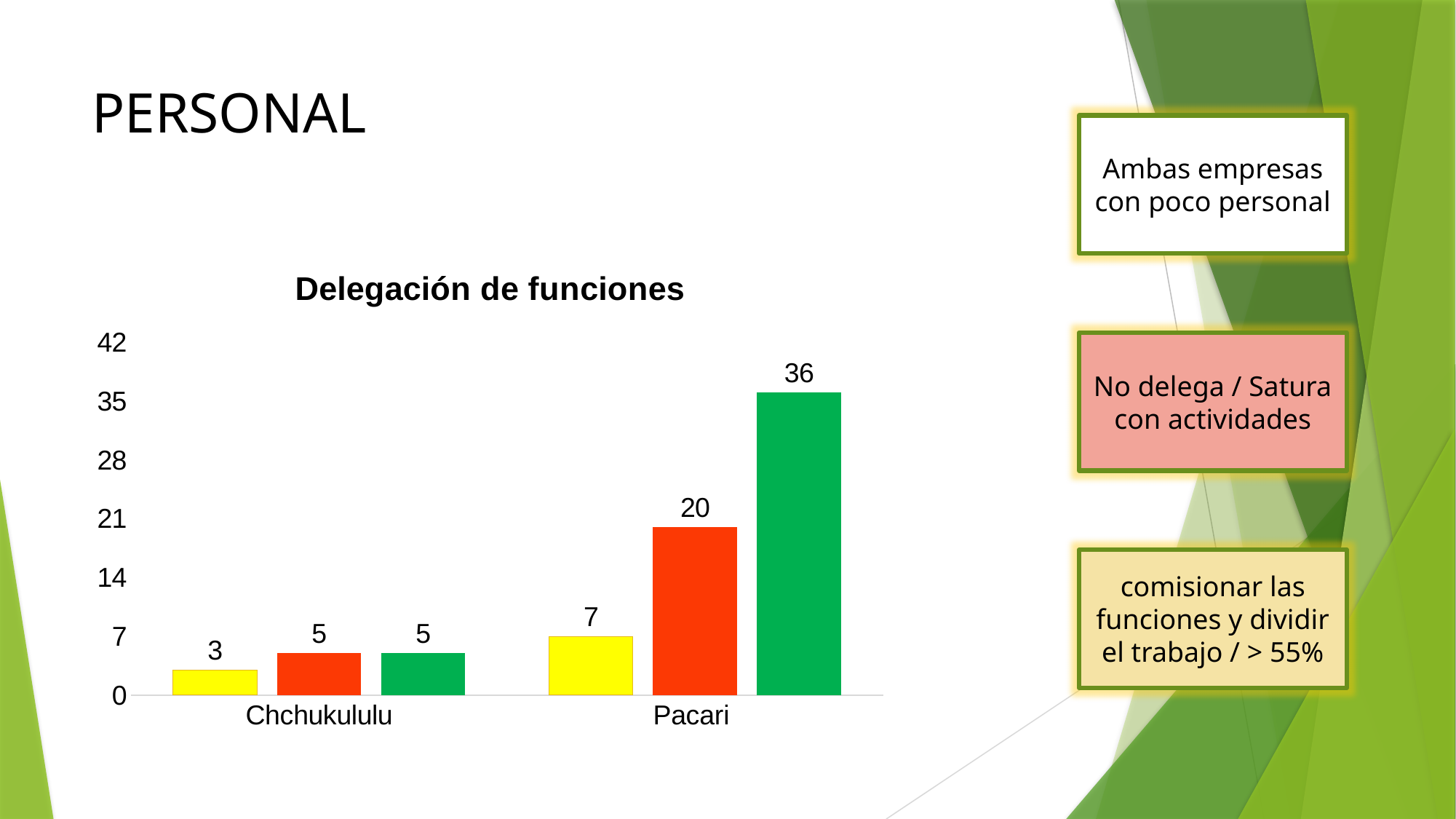
Which category has the highest bar in the chart? Pacari What is the difference between the green bar for Pacari and the green bar for Chchukululu? 31 What is the value of the green bar for Pacari? 36 How many bars are plotted for the Chchukululu category? 3 Which is larger, the red bar for Pacari or the red bar for Chchukululu? Pacari How many categories are shown on the x axis of the chart? 2 What is the value of the yellow bar for Pacari? 7 What is the value of the red bar for Pacari? 20 What type of chart is shown under the title 'Delegación de funciones'? bar chart What is the title of the chart? Delegación de funciones What is the value of the yellow bar for Chchukululu? 3 What is the difference between the red bar and the yellow bar for Pacari? 13